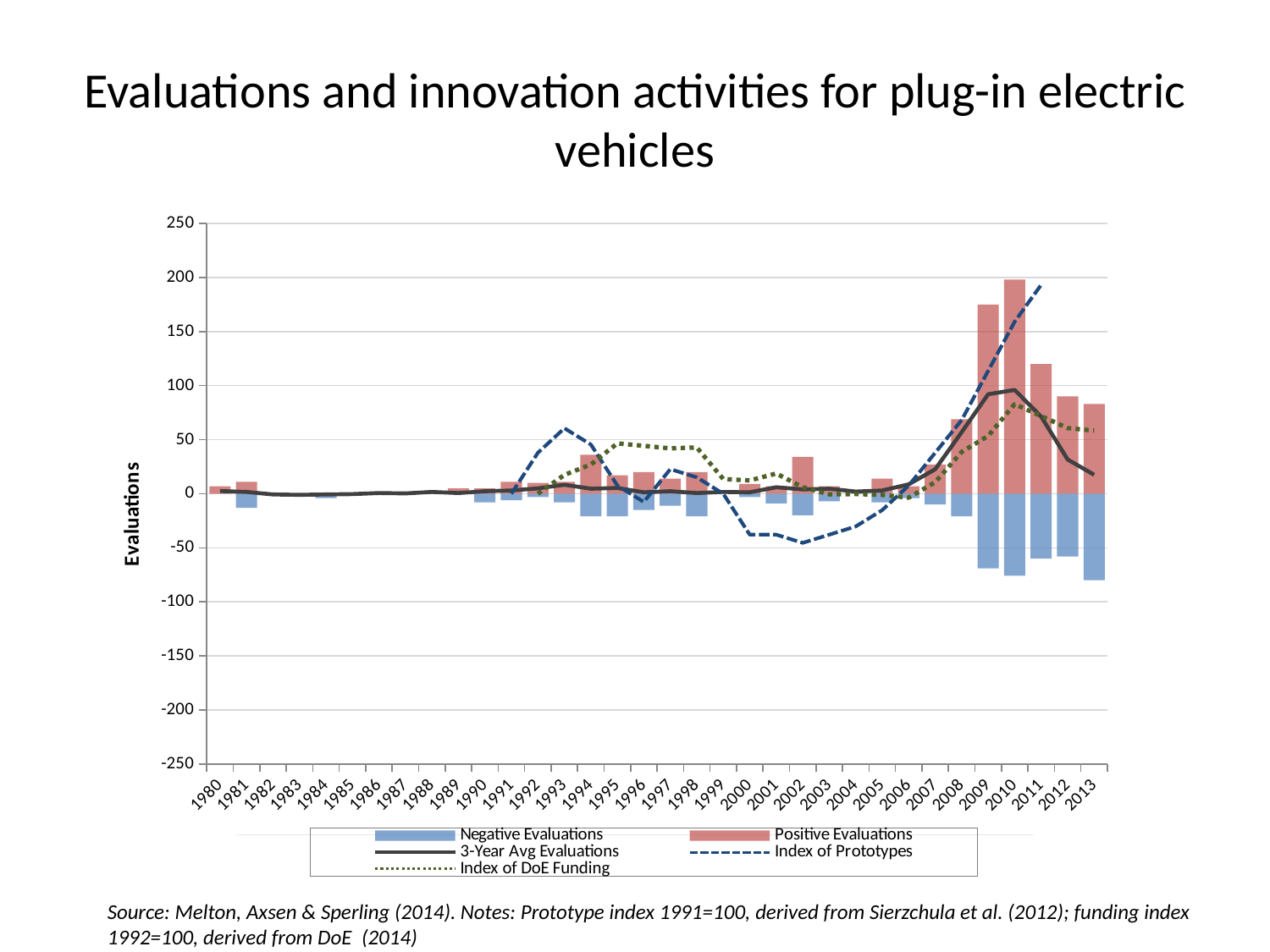
What is the title of the vertical axis? Evaluations How many series does the legend list? 5 Is the Index of Prototypes value for 2011 greater or less than 150? greater Do the Positive Evaluations bars rise or fall from 2010 to 2013? fall In which year does the Index of Prototypes line reach its lowest point? 2002 Is the Positive Evaluations value for 2010 greater or less than 150? greater Is the Index of DoE Funding value for 2010 greater or less than 50? greater Which year has a larger Positive Evaluations bar, 2009 or 2011? 2009 What kind of chart is shown on the slide? A combined bar and line chart How many years are shown along the x axis? 34 In which year is the Positive Evaluations bar highest? 2010